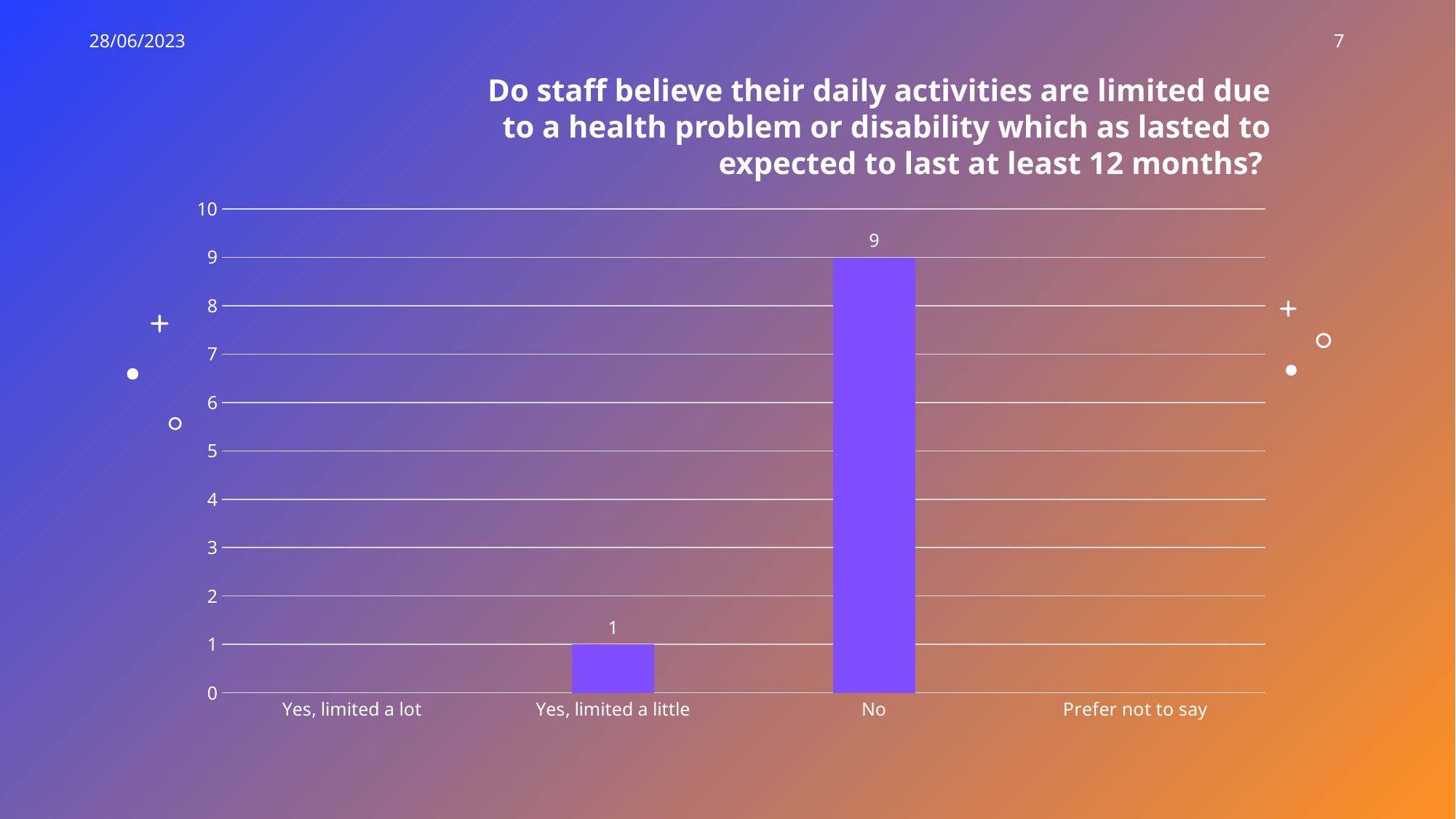
What kind of chart is shown on the slide? bar chart What is the value for "Yes, limited a little"? 1 Which is larger, the value for "No" or the value for "Yes, limited a little"? No What is the value for "No"? 9 How many categories are shown on the x axis? 4 Which category has the highest value? No Is the value for "Yes, limited a little" greater or less than 5? less Is the value for "No" greater or less than 5? greater What is the label of the first category on the x axis? Yes, limited a lot What is the maximum value shown on the y axis? 10 What is the difference between the values for "No" and "Yes, limited a little"? 8